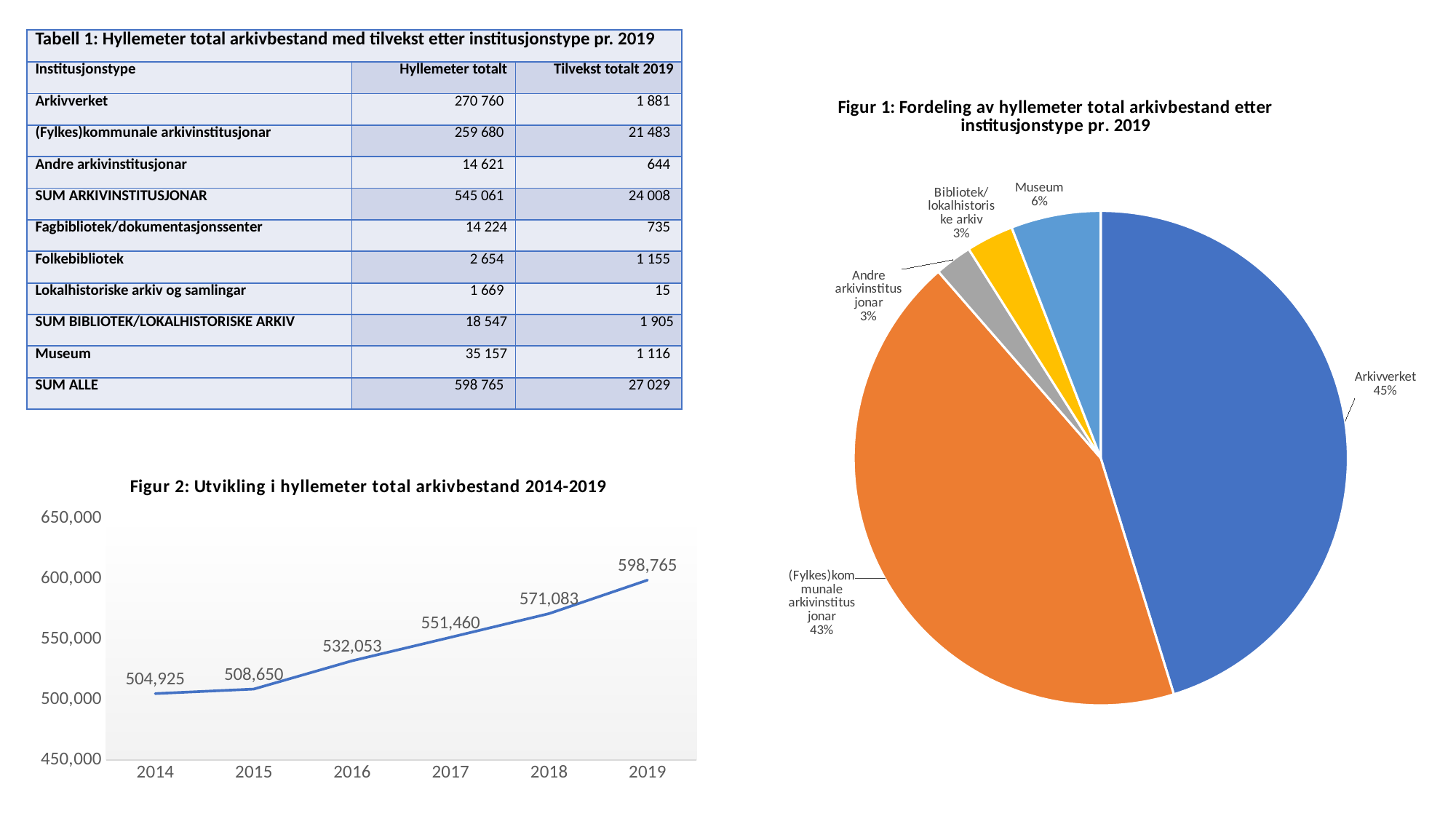
In Figur 2, which year has the lowest value? 2014 What kind of chart is Figur 2: Utvikling i hyllemeter total arkivbestand 2014-2019? line chart In Figur 2, which year has the highest value? 2019 In Figur 2, what is the value for 2014? 504,925 In Figur 2, what is the value for 2017? 551,460 In Figur 1, which slice is the largest? Arkivverket In Figur 1, what share of the pie does Arkivverket have? 45% In Figur 2, do the values rise or fall from 2014 to 2019? rise In Figur 2, how many years are plotted? 6 In Figur 2, what is the value for 2019? 598,765 What kind of chart is Figur 1: Fordeling av hyllemeter total arkivbestand etter institusjonstype pr. 2019? pie chart In Figur 2, what is the difference between the values for 2019 and 2014? 93,840